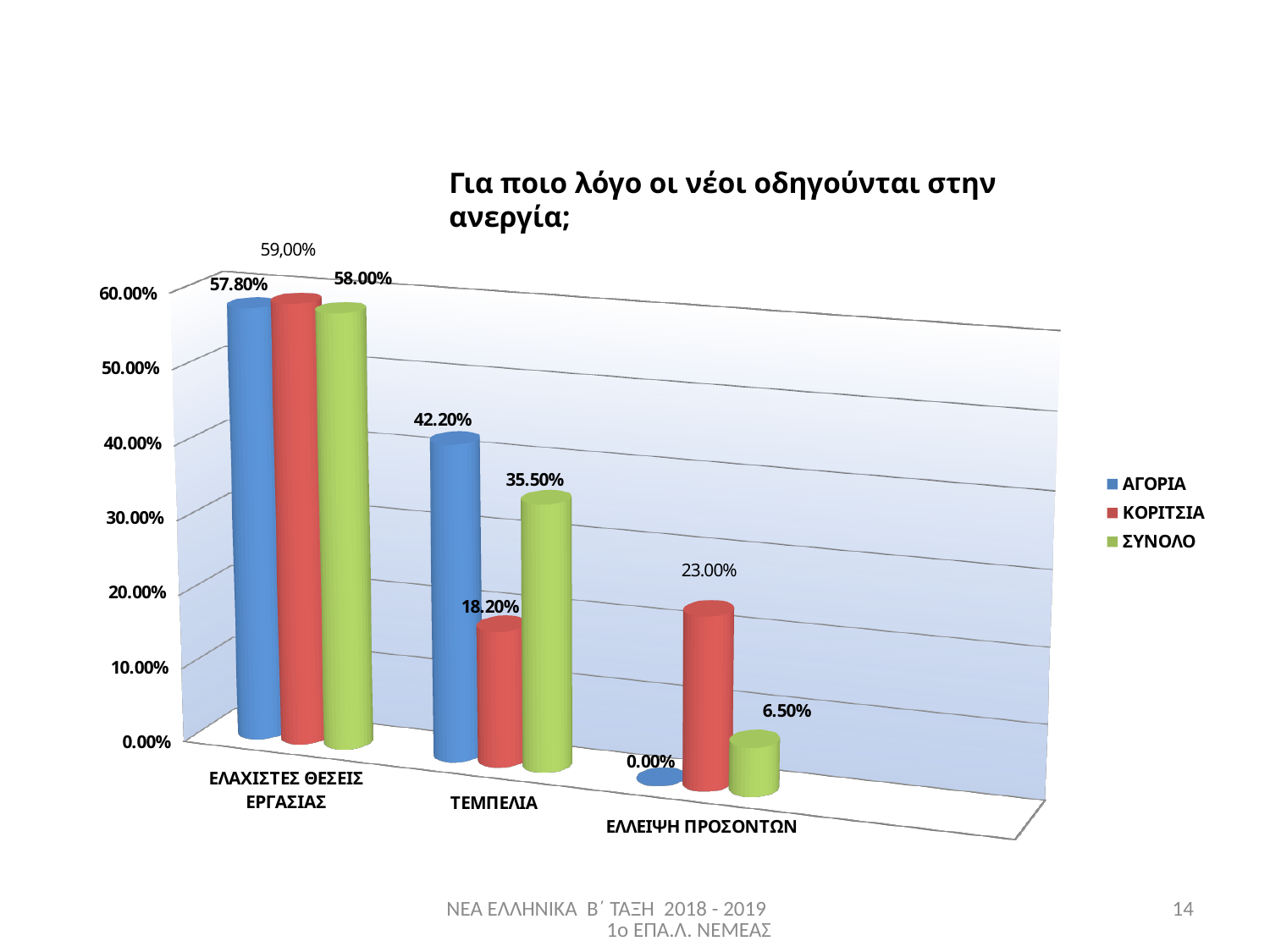
What is the value for ΣΥΝΟΛΟ in the ΕΛΑΧΙΣΤΕΣ ΘΕΣΕΙΣ ΕΡΓΑΣΙΑΣ category? 58.00% What is the value for ΑΓΟΡΙΑ in the ΕΛΛΕΙΨΗ ΠΡΟΣΟΝΤΩΝ category? 0.00% What is the title of the chart? Για ποιο λόγο οι νέοι οδηγούνται στην ανεργία; What is the difference between the ΑΓΟΡΙΑ and ΚΟΡΙΤΣΙΑ values in the ΤΕΜΠΕΛΙΑ category? 24.00% How many series does the legend list? 3 Which category has the highest value for ΑΓΟΡΙΑ? ΕΛΑΧΙΣΤΕΣ ΘΕΣΕΙΣ ΕΡΓΑΣΙΑΣ What is the value for ΚΟΡΙΤΣΙΑ in the ΕΛΛΕΙΨΗ ΠΡΟΣΟΝΤΩΝ category? 23.00% What is the value for ΑΓΟΡΙΑ in the ΤΕΜΠΕΛΙΑ category? 42.20% How many categories are shown on the x axis? 3 What kind of chart is shown on the slide? bar chart Which category has the lowest value for ΣΥΝΟΛΟ? ΕΛΛΕΙΨΗ ΠΡΟΣΟΝΤΩΝ In the ΕΛΛΕΙΨΗ ΠΡΟΣΟΝΤΩΝ category, which is larger, ΚΟΡΙΤΣΙΑ or ΣΥΝΟΛΟ? ΚΟΡΙΤΣΙΑ